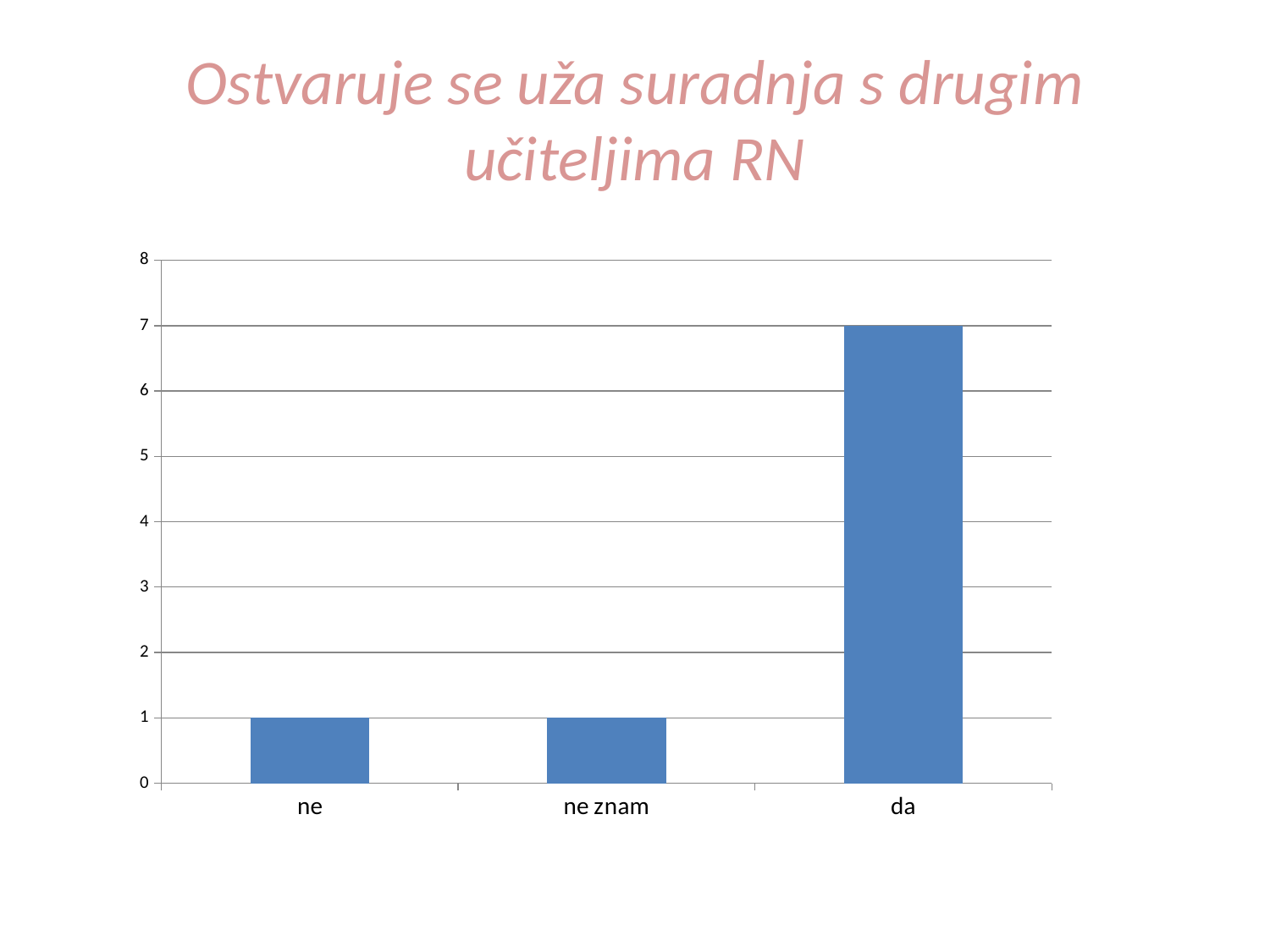
What is the value for "ne znam"? 1 What kind of chart is shown on the slide? bar chart What is the maximum value shown on the vertical axis? 8 Is the value for "ne" greater or less than 4? less What is the value for "da"? 7 Which category has the highest value? da Which is larger, the value for "da" or the value for "ne znam"? da What is the title of the slide above the chart? Ostvaruje se uža suradnja s drugim učiteljima RN What is the value for "ne"? 1 Is the value for "da" greater or less than 5? greater What is the difference between the values for "da" and "ne"? 6 How many categories are shown on the x axis? 3